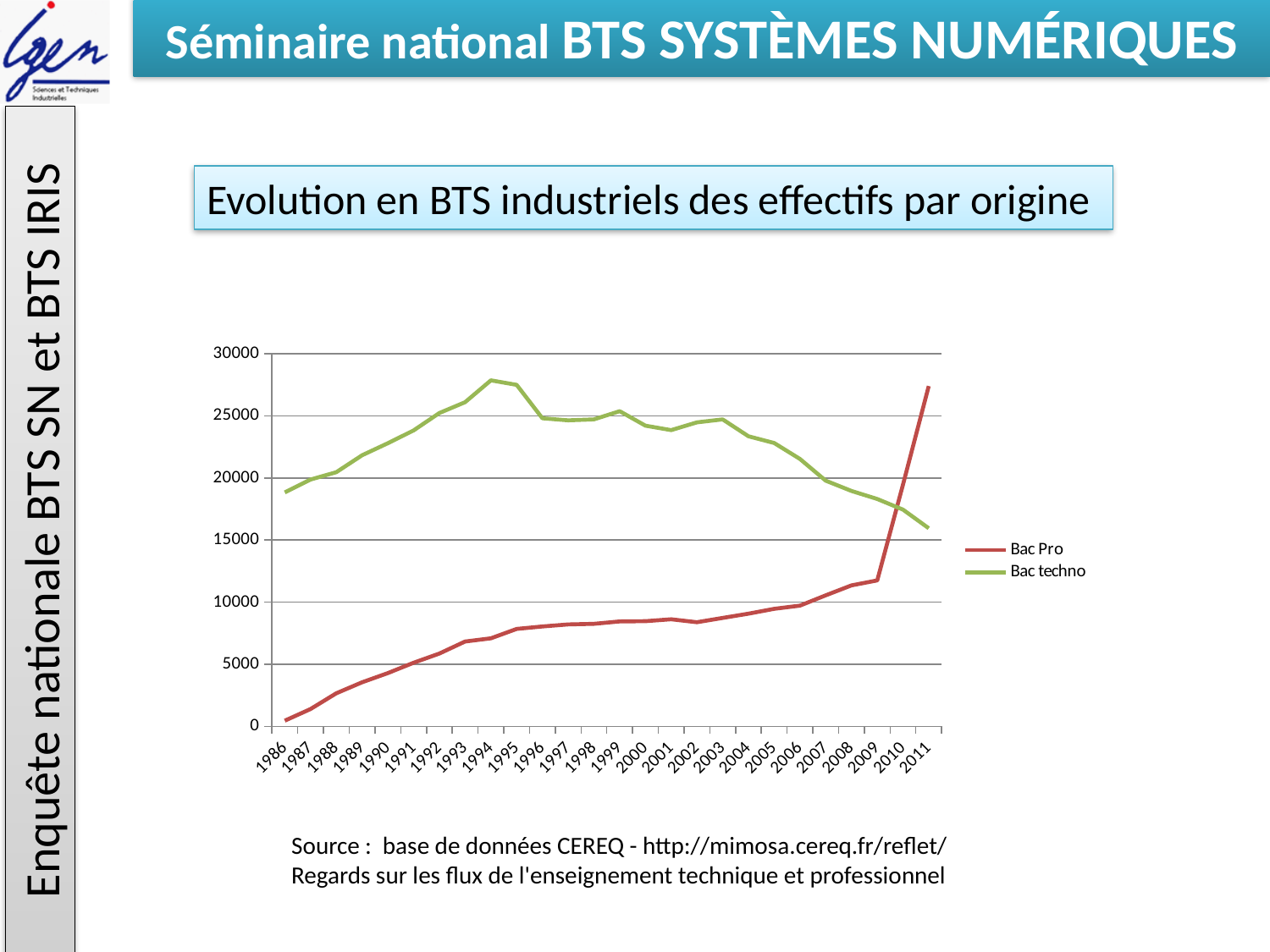
What colour is the Bac techno line? green In which year is the Bac techno series at its lowest? 2011 Is the value for Bac Pro in 2011 greater or less than 25000? greater Which series is higher in 2000, Bac Pro or Bac techno? Bac techno Which series is higher in 2011, Bac Pro or Bac techno? Bac Pro In which year is the Bac Pro series at its lowest? 1986 How many years are shown on the x axis? 26 Does the Bac Pro series generally rise or fall from 1986 to 2011? rise In which year is the Bac Pro series at its highest? 2011 Is the value for Bac techno in 2011 greater or less than 20000? less How many series does the legend list? 2 What kind of chart is shown on the slide? line chart